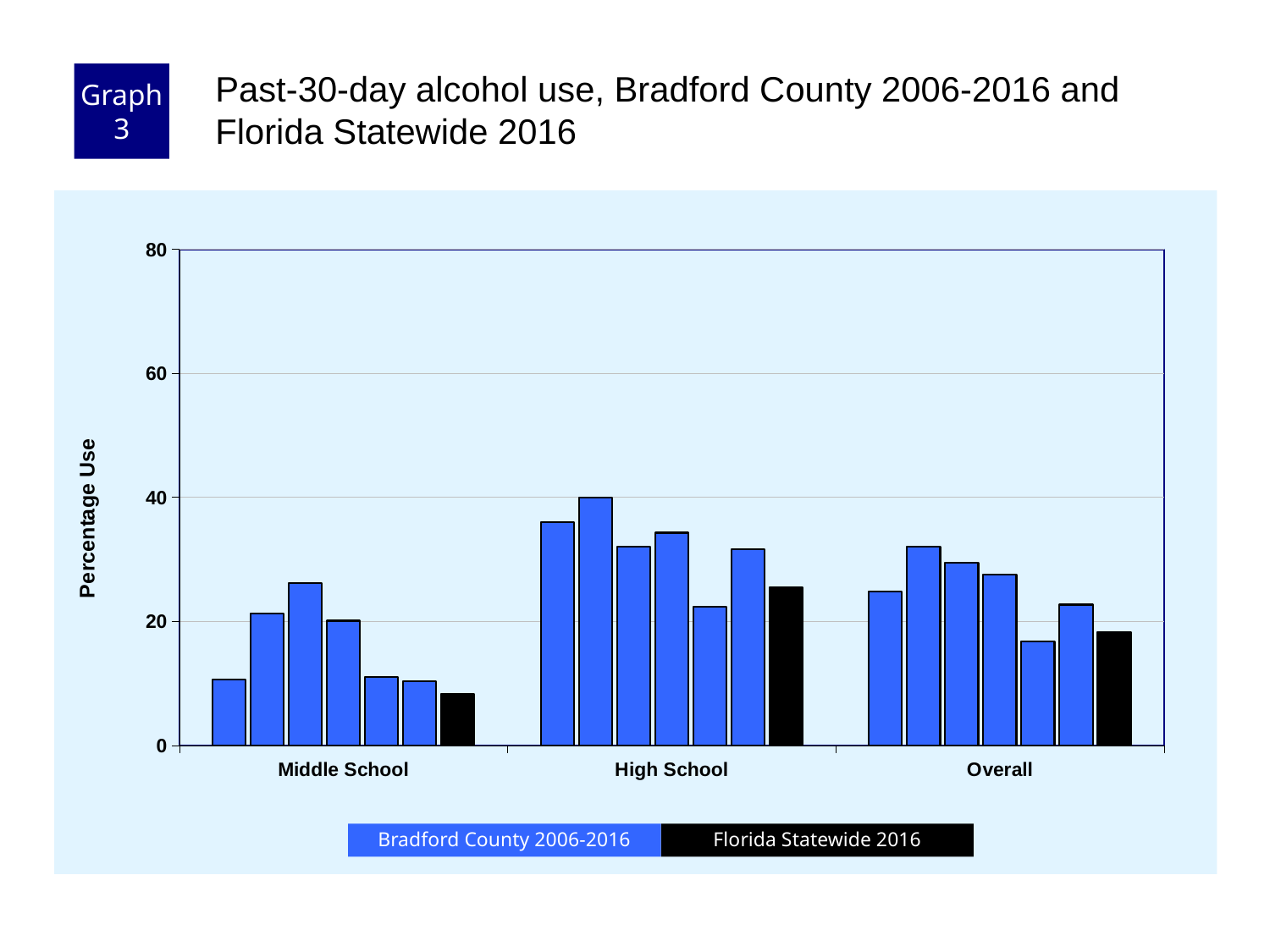
Is the Florida Statewide 2016 value for Middle School greater or less than 20? less Which category has the highest bar in the chart? High School Is the tallest Bradford County bar for Overall greater or less than 40? less What kind of chart is shown on the slide? bar chart How many series does the legend list? 2 What is the label of the y axis? Percentage Use Is the Florida Statewide 2016 value for High School greater or less than 20? greater How many categories are shown on the x axis? 3 Which is larger, the Florida Statewide 2016 value for High School or for Middle School? High School Which colour represents Florida Statewide 2016 in the legend? black